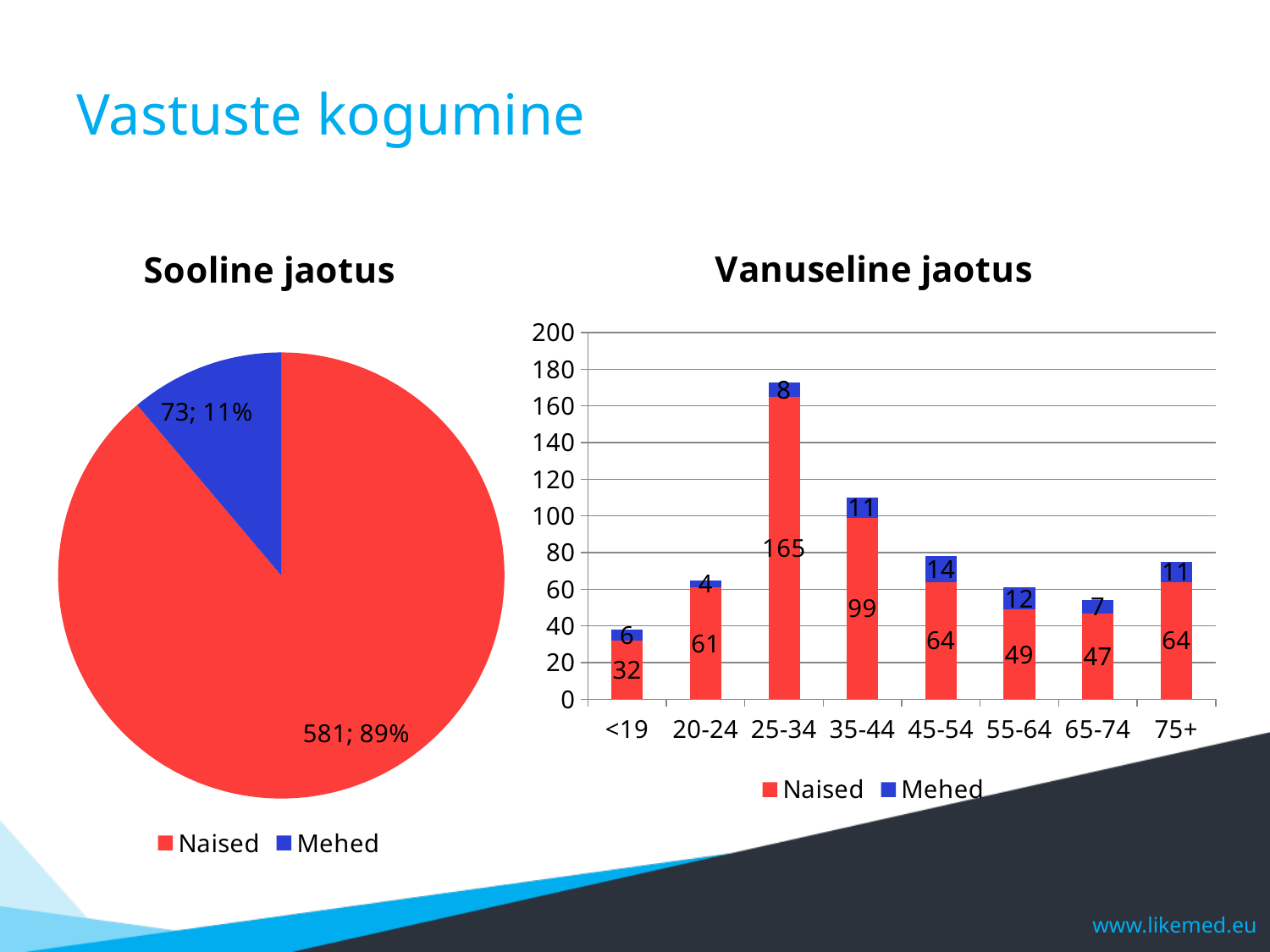
In the Vanuseline jaotus chart, what is the Naised value for the 25-34 age group? 165 How many age groups are shown on the x axis of the Vanuseline jaotus chart? 8 How many series does the legend of the Vanuseline jaotus chart list? 2 In the Vanuseline jaotus chart, which age group has the highest Naised value? 25-34 What kind of chart is Sooline jaotus? Pie chart In the Vanuseline jaotus chart, what is the Mehed value for the 45-54 age group? 14 In the Vanuseline jaotus chart, which age group has the lowest Mehed value? 20-24 In the Vanuseline jaotus chart, what is the difference between the Naised values for 25-34 and 35-44? 66 In the Vanuseline jaotus chart, what is the total of the stacked bar for the 35-44 age group? 110 In the Sooline jaotus pie chart, what share of the pie does Mehed represent? 11% In the Sooline jaotus pie chart, what value is shown for Naised? 581; 89% In the Vanuseline jaotus chart, is the Naised value for 55-64 or 65-74 larger? 55-64